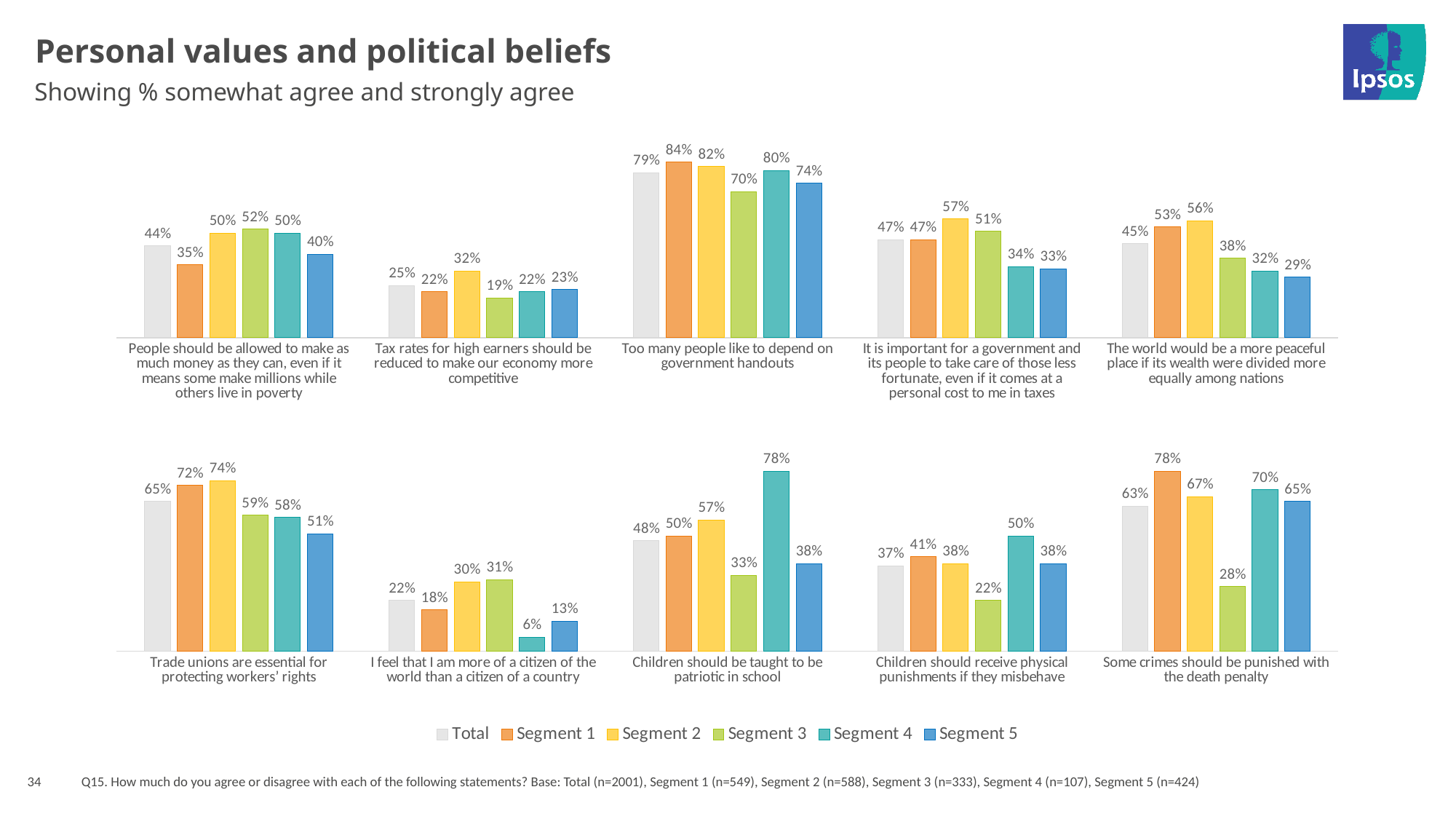
In the bottom chart, which series has the lowest value for "I feel that I am more of a citizen of the world than a citizen of a country"? Segment 4 How many statements are shown in the top chart? 5 In the top chart, what is the highest value shown for "Too many people like to depend on government handouts", and which series does it belong to? 84%, Segment 1 How many series does the legend list? 6 In the bottom chart, what is the Segment 4 value for "Children should be taught to be patriotic in school"? 78% What does the subtitle say the charts are showing? % somewhat agree and strongly agree In the bottom chart, which is larger for "Trade unions are essential for protecting workers' rights": Segment 3 or Segment 5? Segment 3 In the top chart, what is the Total value for "Too many people like to depend on government handouts"? 79% In the bottom chart, which series has the highest value for "Some crimes should be punished with the death penalty"? Segment 1 What type of chart is used on this slide? Bar chart In the top chart, what is the difference between the Segment 2 and Segment 5 values for "The world would be a more peaceful place if its wealth were divided more equally among nations"? 27 percentage points In the bottom chart, what is the Segment 3 value for "Children should receive physical punishments if they misbehave"? 22%